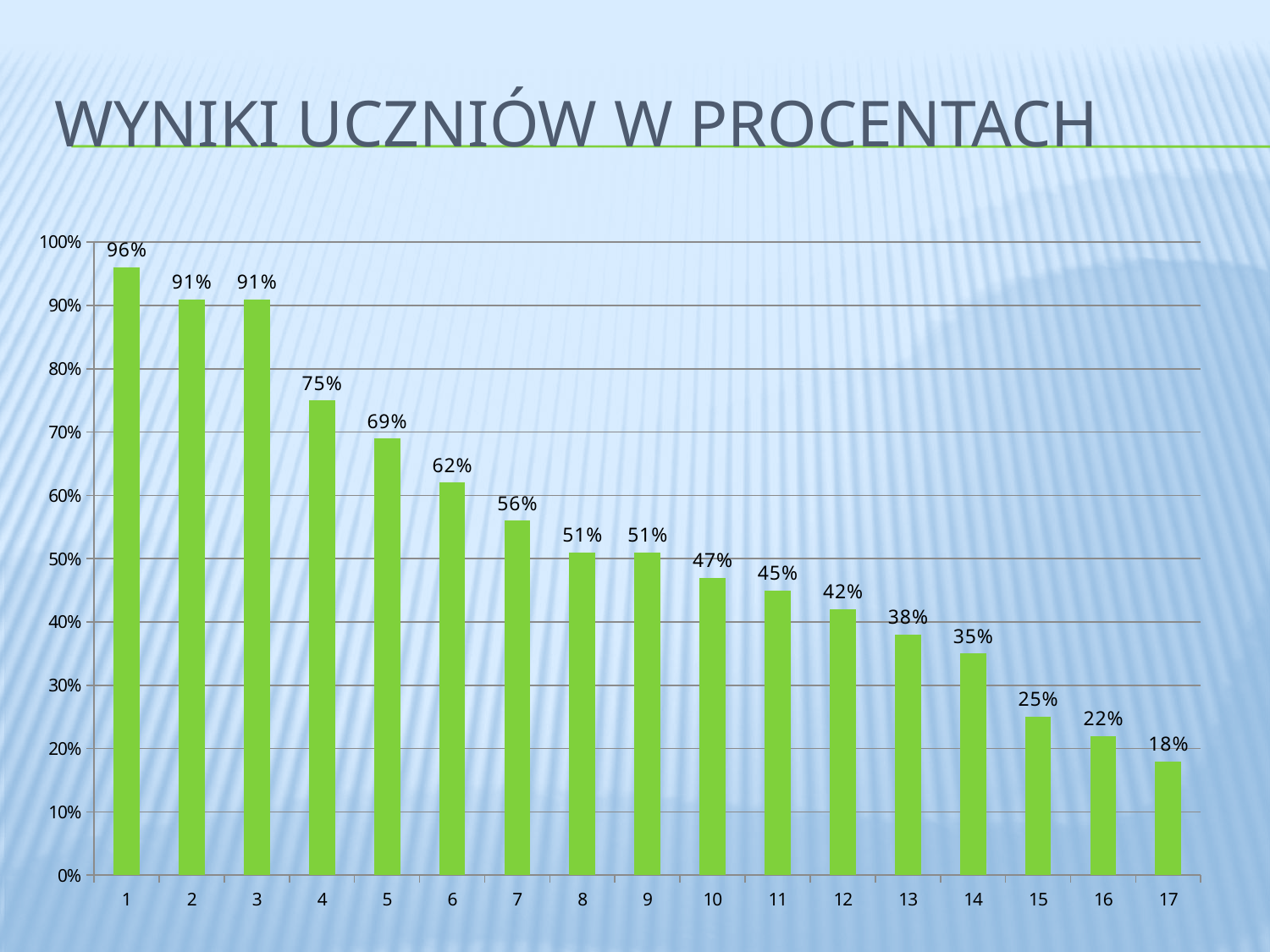
What is the value for category 10? 47% What is the value for category 1? 96% What is the title of the chart on the slide? WYNIKI UCZNIÓW W PROCENTACH What is the value for category 17? 18% How many categories are shown on the x axis? 17 Is the value for category 14 greater or less than 40%? less What kind of chart is shown on the slide? bar chart Which category has the lowest value? 17 Which is larger, the value for category 7 or the value for category 12? category 7 What is the difference between the values for category 4 and category 5? 6% Which category has the highest value? 1 Do the values rise or fall from category 1 to category 17? fall